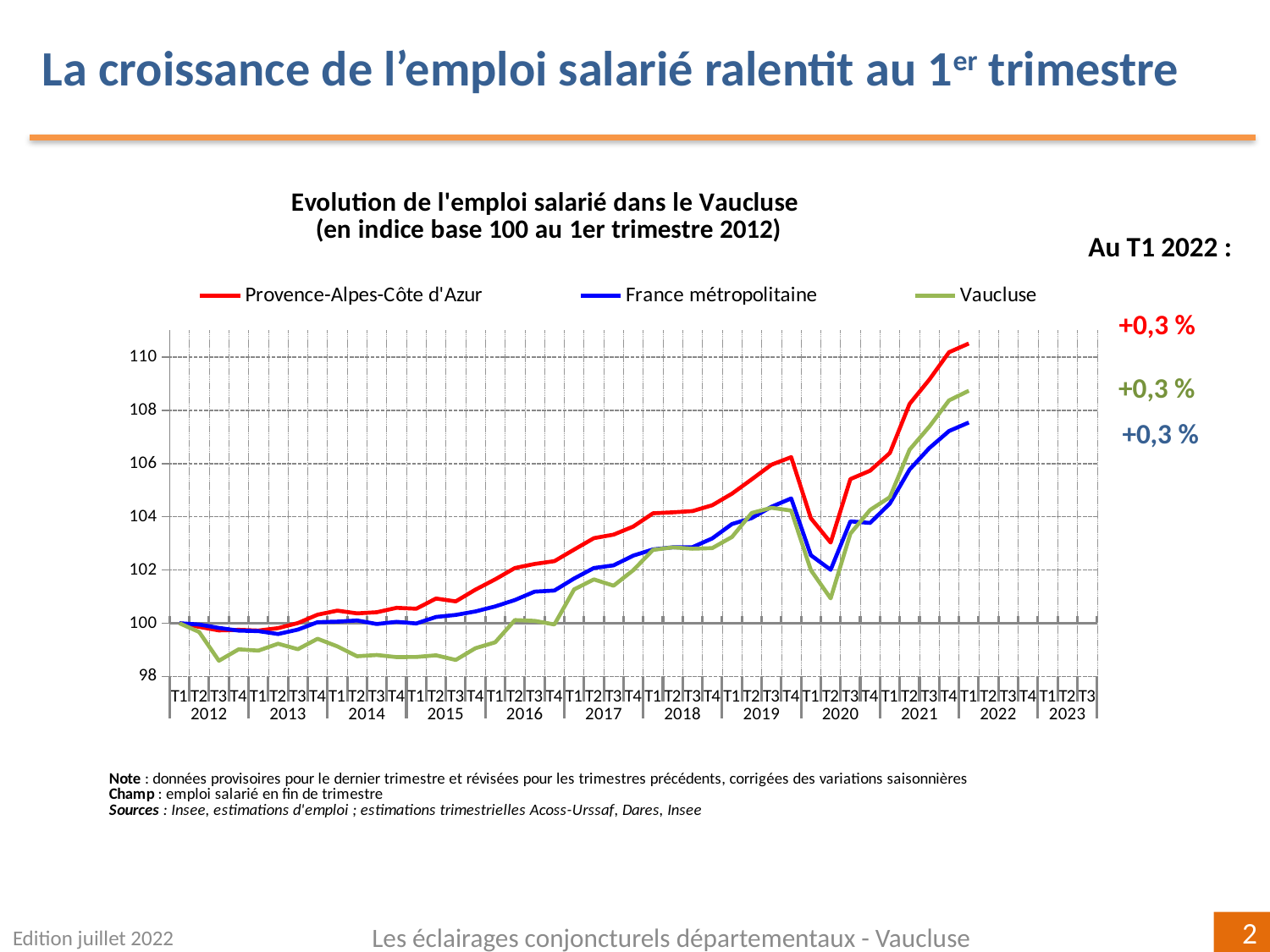
How many series does the legend list? 3 What is the title of the chart? Evolution de l'emploi salarié dans le Vaucluse (en indice base 100 au 1er trimestre 2012) What change is shown for France métropolitaine at T1 2022 in the annotation on the right? +0,3 % Which series is drawn in red? Provence-Alpes-Côte d'Azur Which series has the lowest value at T1 2022? France métropolitaine Which series has the highest value at T1 2022? Provence-Alpes-Côte d'Azur Is the value for Vaucluse at T3 2015 greater or less than 100? less What kind of chart is shown on the slide? line chart Overall, does the Vaucluse series rise or fall between 2012 and 2022? rise What change is shown for Vaucluse at T1 2022 in the annotation on the right? +0,3 % At T4 2019, which is higher: Provence-Alpes-Côte d'Azur or Vaucluse? Provence-Alpes-Côte d'Azur Is the value for Provence-Alpes-Côte d'Azur at T1 2022 greater or less than 110? greater